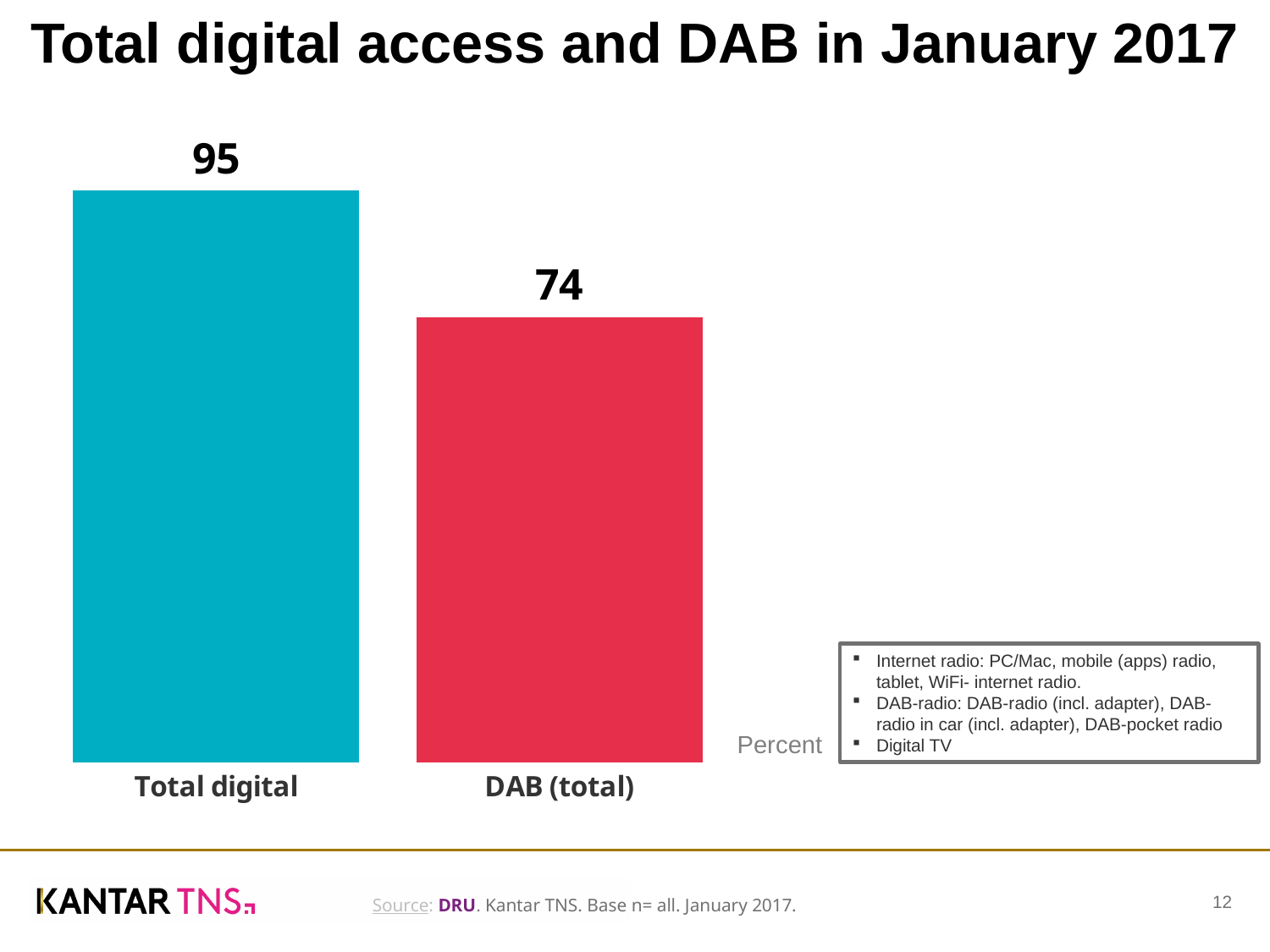
Which category has the lowest value? DAB (total) What is the value for DAB (total)? 74 What is the title of the slide? Total digital access and DAB in January 2017 How many categories are shown in the chart? 2 Which category has the highest value? Total digital What is the value for Total digital? 95 What unit are the values in, according to the label next to the chart? Percent What kind of chart is shown on the slide? Bar chart What is the difference between the values for Total digital and DAB (total)? 21 Which is larger, the value for Total digital or the value for DAB (total)? Total digital